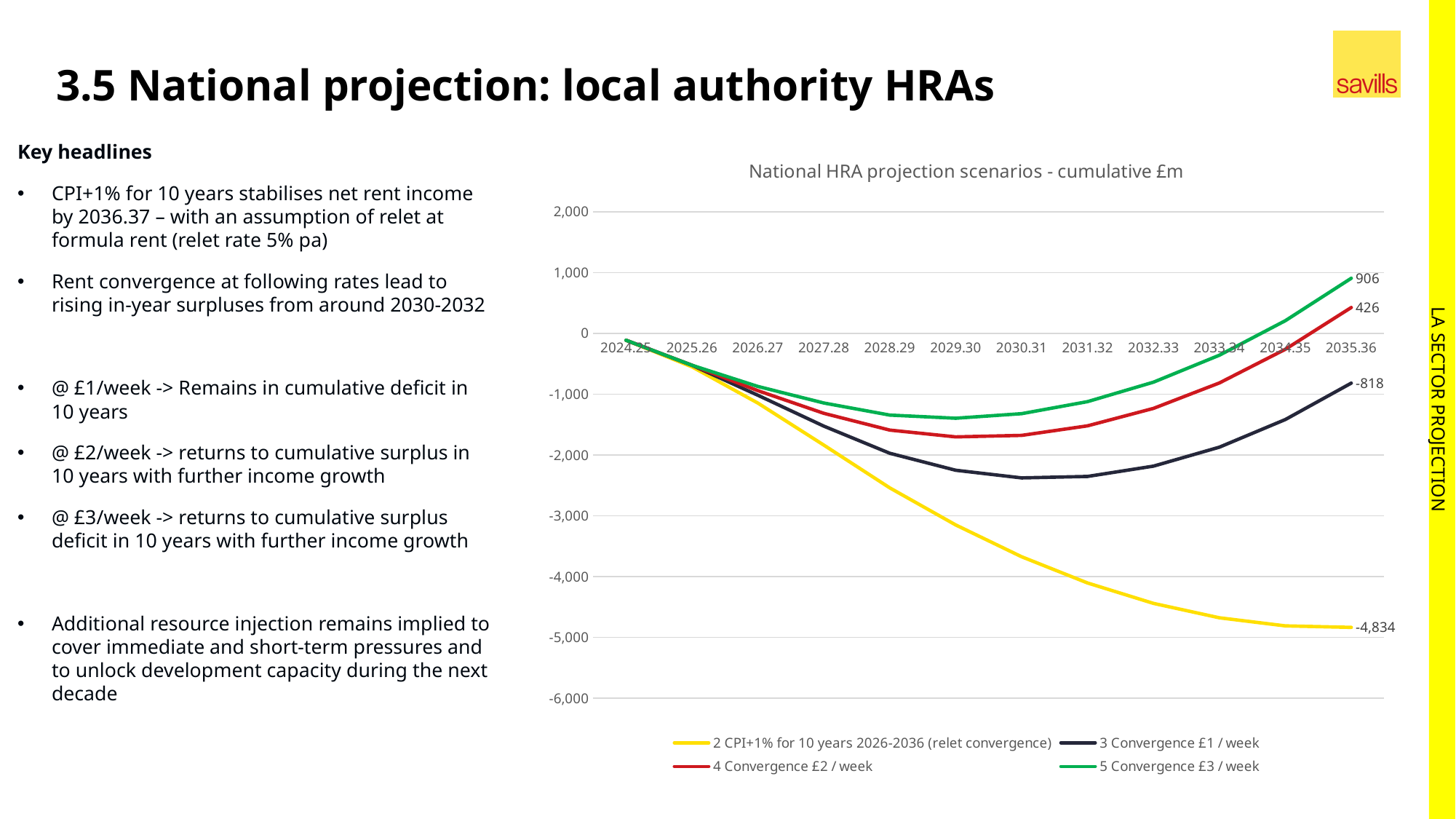
What kind of chart is shown on the slide? line chart How many series does the legend list? 4 Which series has the highest value at 2035.36? 5 Convergence £3 / week What is the cumulative value for '3 Convergence £1 / week' at 2035.36? -818 What is the cumulative value for '5 Convergence £3 / week' at 2035.36? 906 What is the cumulative value for '4 Convergence £2 / week' at 2035.36? 426 How many years are shown on the x axis? 12 What is the cumulative value for '2 CPI+1% for 10 years 2026-2036 (relet convergence)' at 2035.36? -4,834 Is the value for '2 CPI+1% for 10 years 2026-2036 (relet convergence)' at 2031.32 greater or less than -3,000? less At 2035.36, which is larger: '4 Convergence £2 / week' or '3 Convergence £1 / week'? 4 Convergence £2 / week Which series has the lowest value at 2035.36? 2 CPI+1% for 10 years 2026-2036 (relet convergence) What is the difference between the 2035.36 values of '5 Convergence £3 / week' and '4 Convergence £2 / week'? 480